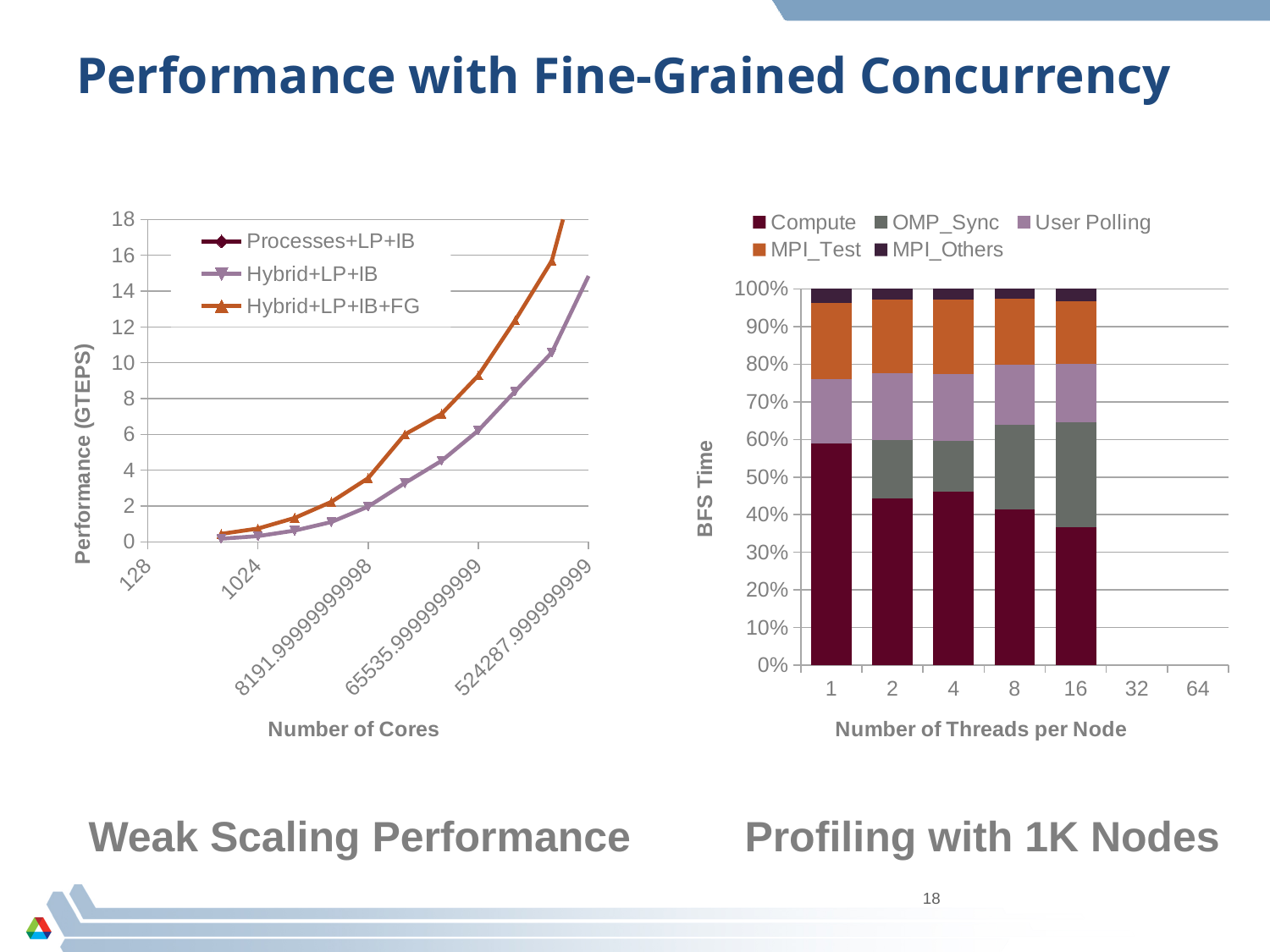
In the Weak Scaling Performance chart, do the values for Hybrid+LP+IB+FG rise or fall as the number of cores increases? rise In the Profiling with 1K Nodes chart, how many bars are plotted? 5 In the Profiling with 1K Nodes chart, at which number of threads per node is the Compute share the largest? 1 In the Profiling with 1K Nodes chart, is the Compute share for 1 thread per node greater or less than 50%? greater How many series does the legend of the Profiling with 1K Nodes chart list? 5 In the Weak Scaling Performance chart, at 65535.9999999999 cores, which series is higher: Hybrid+LP+IB+FG or Hybrid+LP+IB? Hybrid+LP+IB+FG How many series does the legend of the Weak Scaling Performance chart list? 3 In the Weak Scaling Performance chart, is the value for Hybrid+LP+IB+FG at 65535.9999999999 cores greater or less than 2? greater What type of chart is the Profiling with 1K Nodes chart on the right? stacked bar chart In the Profiling with 1K Nodes chart, at which number of threads per node is the Compute share the smallest? 16 In the Weak Scaling Performance chart, is the value for Hybrid+LP+IB at 524287.999999999 cores greater or less than 12? greater What type of chart is the Weak Scaling Performance chart on the left? line chart